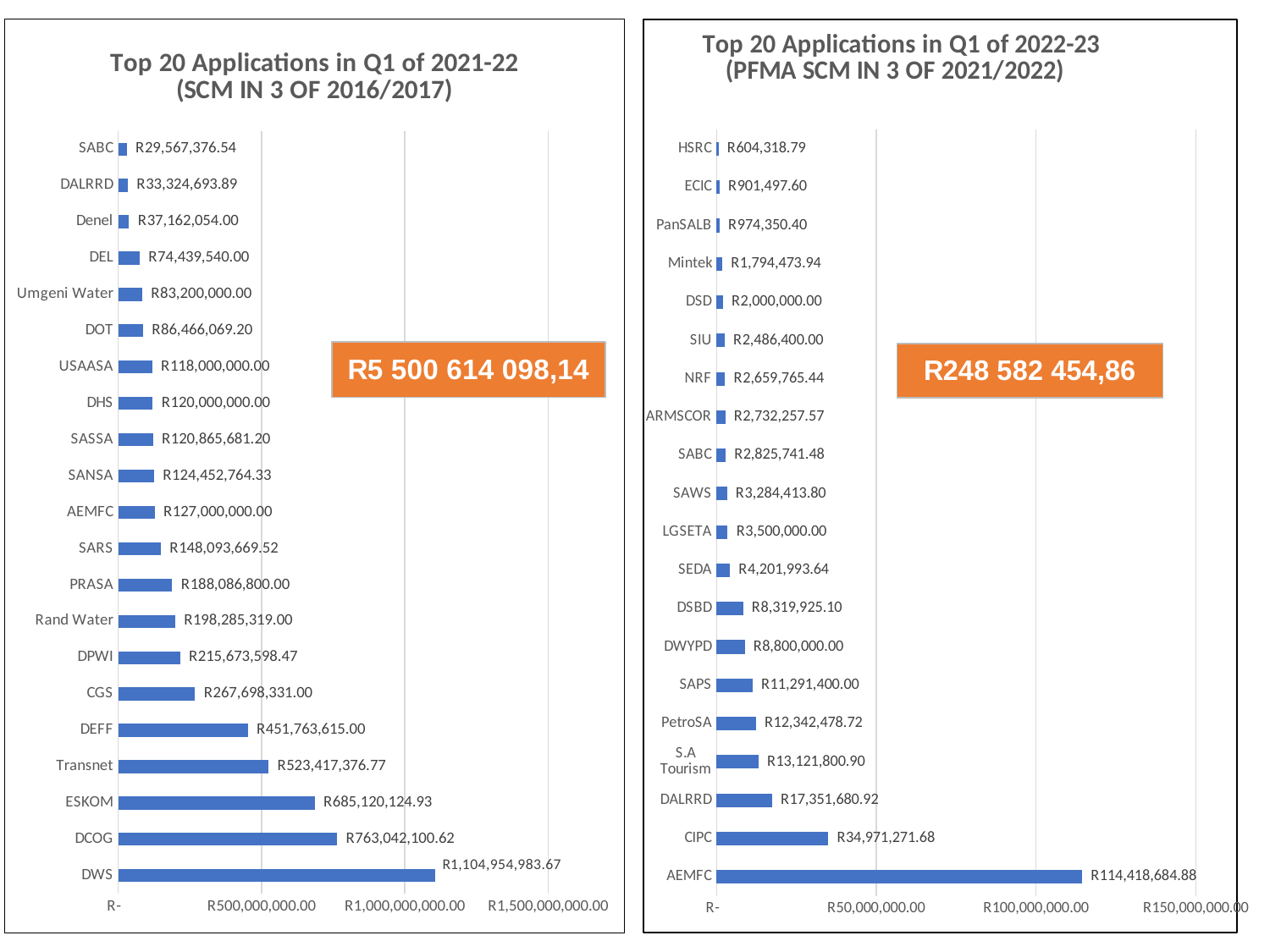
In the 'Top 20 Applications in Q1 of 2021-22' chart, is the value for DWS greater or less than R1,000,000,000.00? greater In the 'Top 20 Applications in Q1 of 2021-22' chart, what is the value for DWS? R1,104,954,983.67 In the 'Top 20 Applications in Q1 of 2021-22' chart, what is the difference between the values for DWS and DCOG? R341,912,883.05 In the 'Top 20 Applications in Q1 of 2022-23' chart, what is the difference between the values for AEMFC and CIPC? R79,447,413.20 In the 'Top 20 Applications in Q1 of 2021-22' chart, which category has the lowest value? SABC In the 'Top 20 Applications in Q1 of 2022-23' chart, how many categories are plotted? 20 What kind of chart is the 'Top 20 Applications in Q1 of 2022-23' chart? Bar chart In the 'Top 20 Applications in Q1 of 2021-22' chart, what is the value for Transnet? R523,417,376.77 In the 'Top 20 Applications in Q1 of 2022-23' chart, what is the value for CIPC? R34,971,271.68 In the 'Top 20 Applications in Q1 of 2022-23' chart, which category has the highest value? AEMFC In the 'Top 20 Applications in Q1 of 2022-23' chart, which is larger, the value for SAPS or the value for DALRRD? DALRRD In the 'Top 20 Applications in Q1 of 2021-22' chart, how many categories are plotted? 21